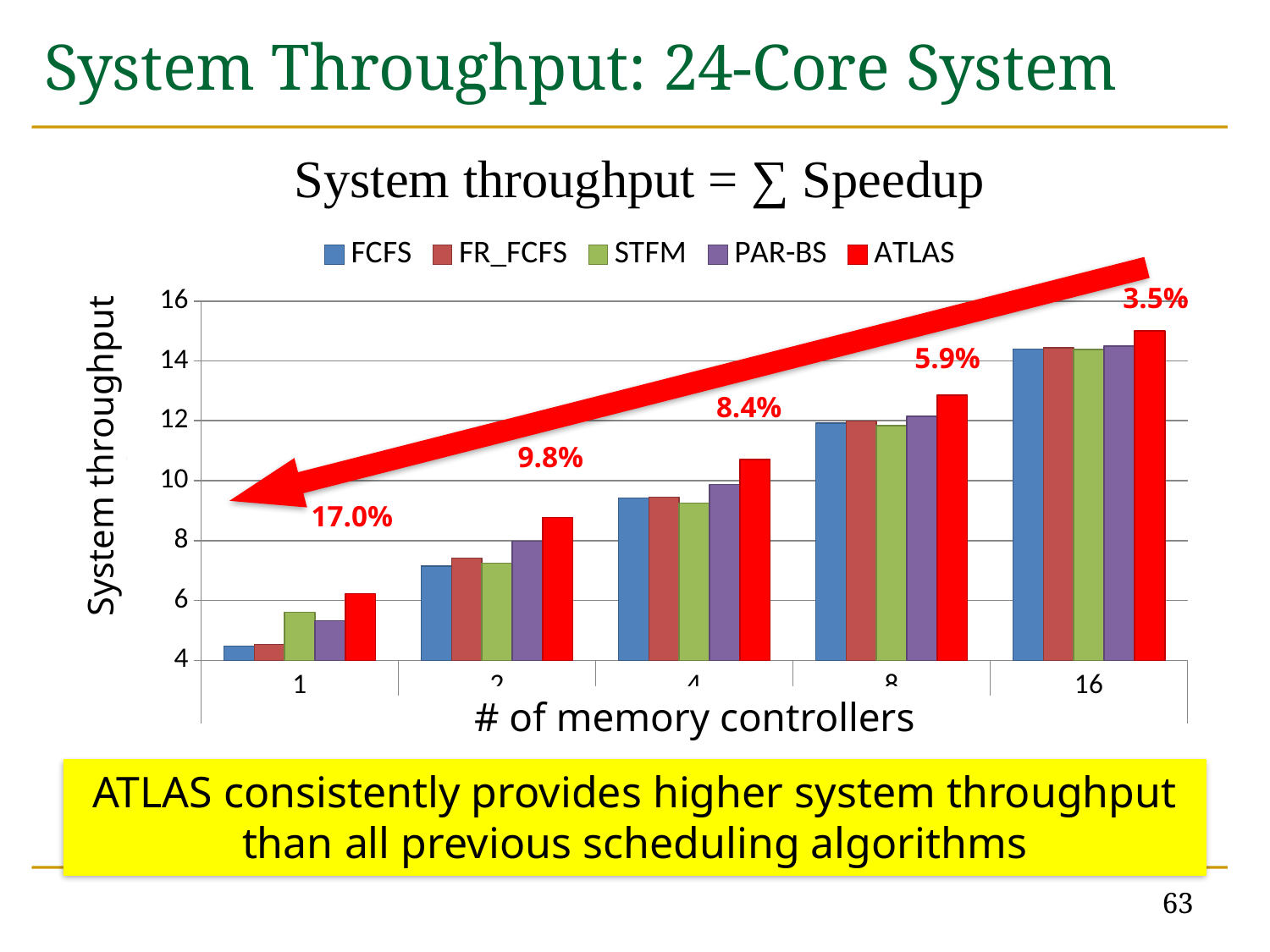
For which number of memory controllers is the ATLAS bar the tallest? 16 Is the value for FCFS at 1 memory controller greater or less than 6? less What kind of chart is shown on the slide? bar chart Which series has the highest system throughput for 16 memory controllers? ATLAS Do the system throughput values rise or fall as the number of memory controllers increases? rise How many categories (numbers of memory controllers) are shown on the x axis? 5 Which is larger at 1 memory controller, the STFM bar or the PAR-BS bar? STFM Is the value for ATLAS at 16 memory controllers greater or less than 14? greater Is the value for STFM at 4 memory controllers greater or less than 10? less How many series does the legend list? 5 What percentage is annotated above the bar group for 1 memory controller? 17.0% What is the title of the y axis? System throughput